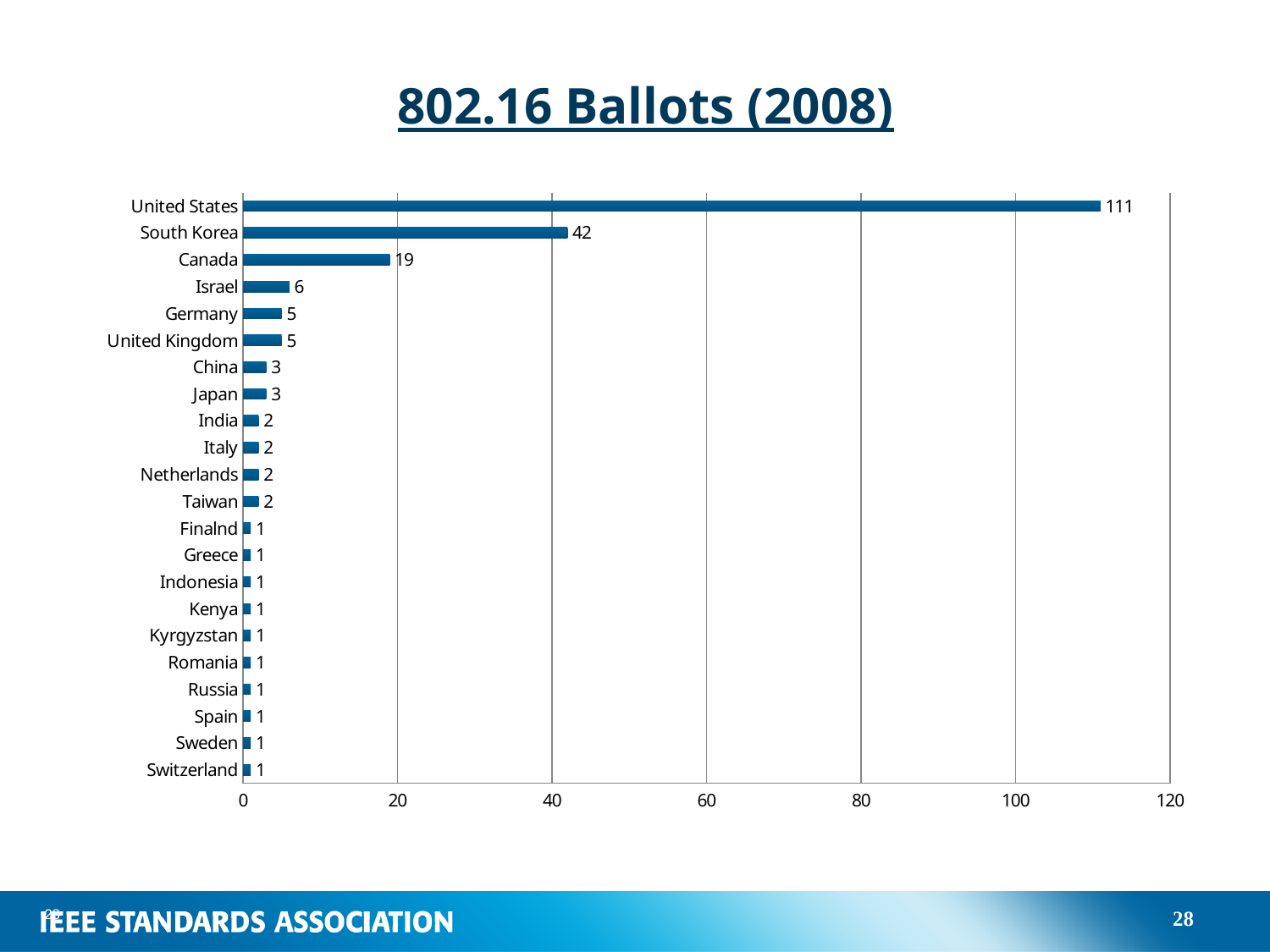
What is the value for the United States? 111 How many countries are shown in the chart? 22 Which is larger, the value for Israel or the value for Germany? Israel Is the value for the United States greater or less than 100? greater What is the difference between the values for South Korea and Canada? 23 What is the difference between the values for the United States and South Korea? 69 What is the value for Canada? 19 What is the title of the chart? 802.16 Ballots (2008) What kind of chart is shown on the slide? bar chart What is the value for Israel? 6 Which country has the highest number of ballots? United States What is the value for South Korea? 42